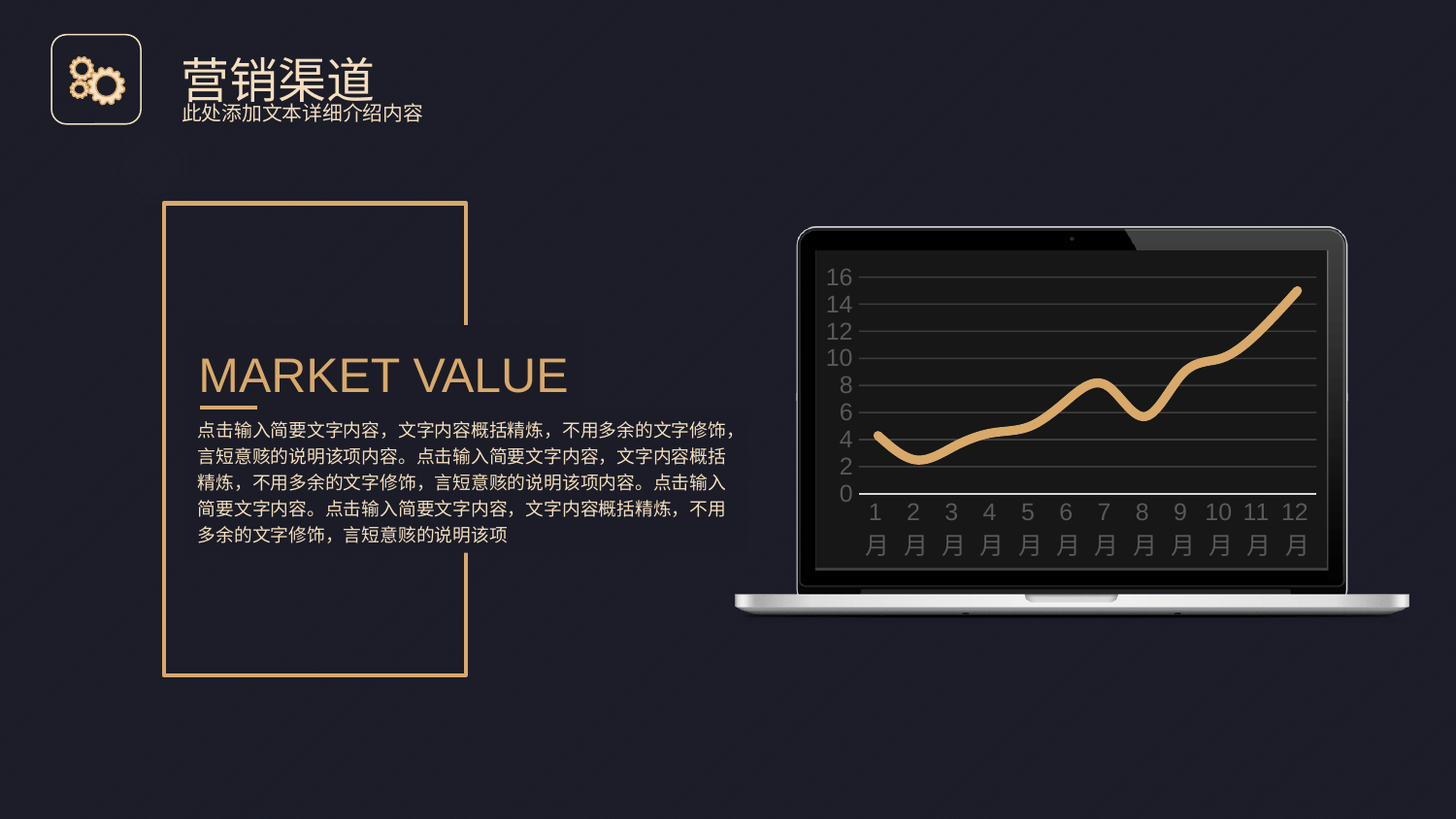
Which is larger, the value for 7月 or the value for 8月? 7月 Which is larger, the value for 1月 or the value for 12月? 12月 Which month has the highest value on the chart? 12月 Overall, do the values rise or fall from 1月 to 12月? rise Is the value for 7月 greater or less than 6? greater How many months are plotted along the x axis of the chart? 12 Is the value for 12月 greater or less than 14? greater What kind of chart is shown on the laptop screen? line chart Is the value for 11月 greater or less than 10? greater What is the highest tick value shown on the y axis of the chart? 16 Which month has the lowest value on the chart? 2月